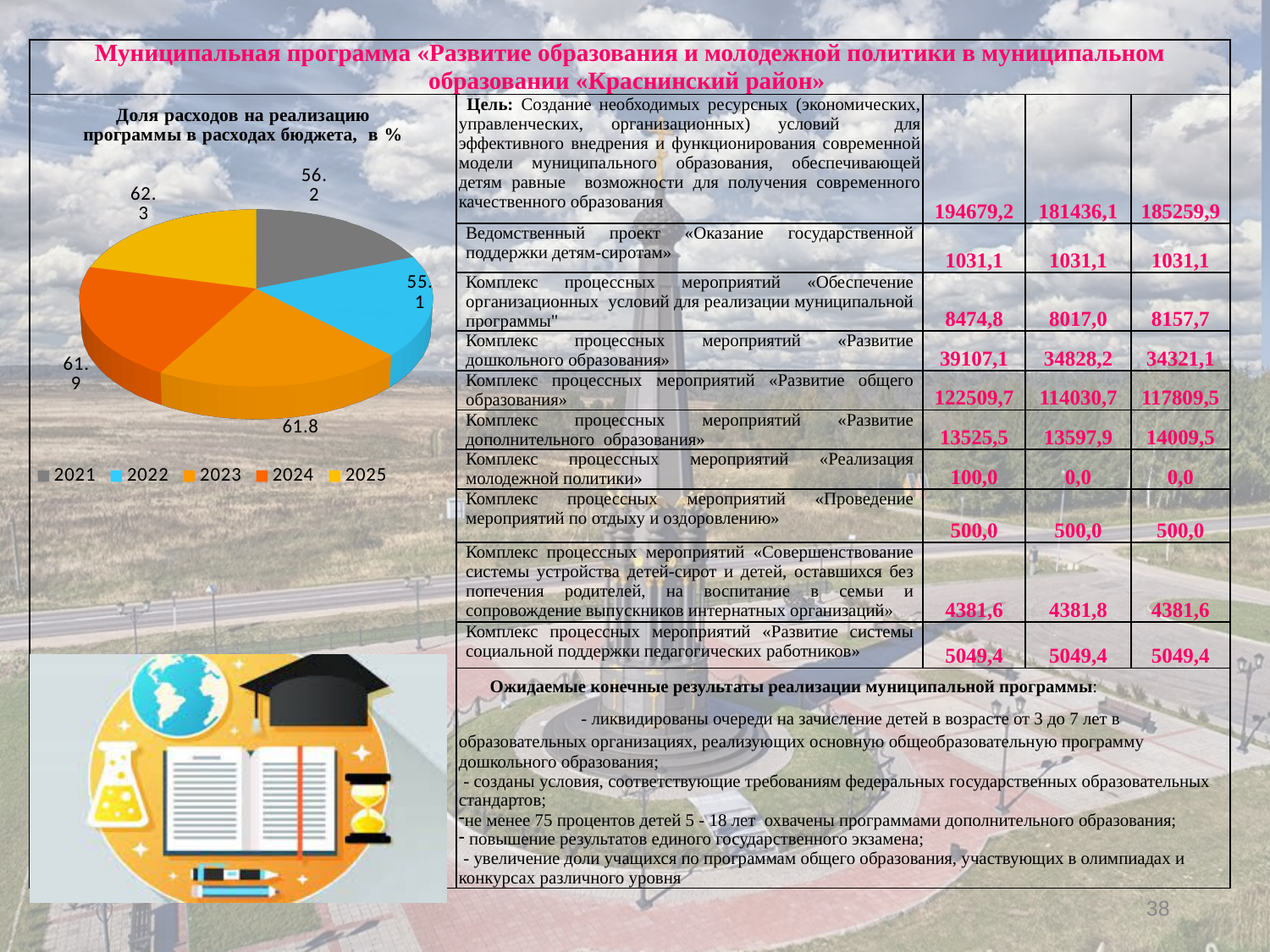
What value is shown for 2025 in the pie chart? 62.3 What is the title of the pie chart? Доля расходов на реализацию программы в расходах бюджета, в % Which is larger in the pie chart, the value for 2023 or the value for 2021? 2023 What value is shown for 2022 in the pie chart? 55.1 Which year has the lowest value in the pie chart? 2022 Which year has the highest value in the pie chart? 2025 How many entries does the pie chart legend list? 5 What value is shown for 2023 in the pie chart? 61.8 How many slices does the pie chart have? 5 What value is shown for 2021 in the pie chart? 56.2 What is the difference between the values for 2025 and 2022 in the pie chart? 7.2 What kind of chart is shown on the slide? pie chart